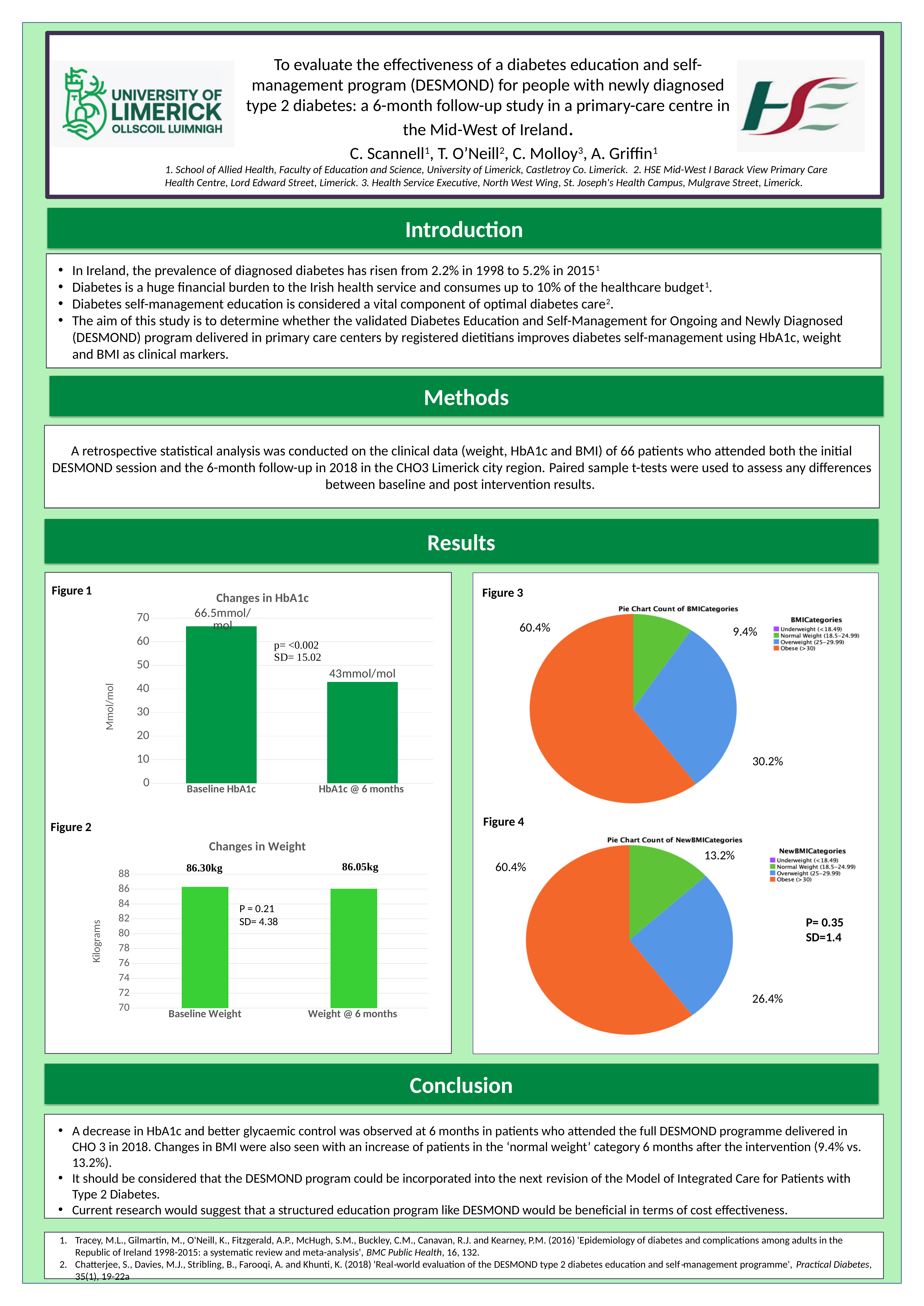
What kind of chart is the 'Changes in Weight' chart (Figure 2)? bar chart In the 'Pie Chart Count of BMICategories' (Figure 3), what share of the pie is the Obese (>30) slice? 60.4% In the 'Changes in Weight' chart (Figure 2), what is the difference between Baseline Weight and Weight @ 6 months? 0.25kg In the 'Changes in Weight' chart (Figure 2), what is the value for Baseline Weight? 86.30kg In the 'Pie Chart Count of BMICategories' (Figure 3), which category has the largest slice? Obese (>30) In the 'Changes in HbA1c' chart (Figure 1), what is the value for HbA1c @ 6 months? 43mmol/mol In the 'Pie Chart Count of NewBMICategories' (Figure 4), what share of the pie is the Normal Weight (18.5-24.99) slice? 13.2% In the 'Changes in Weight' chart (Figure 2), what is the value for Weight @ 6 months? 86.05kg How many categories does the legend of the 'Pie Chart Count of NewBMICategories' (Figure 4) list? 4 In the 'Changes in HbA1c' chart (Figure 1), what is the value for Baseline HbA1c? 66.5mmol/mol In the 'Changes in HbA1c' chart (Figure 1), is the value for Baseline HbA1c greater or less than 60? greater In the 'Changes in HbA1c' chart (Figure 1), by how much did HbA1c fall from baseline to 6 months? 23.5mmol/mol